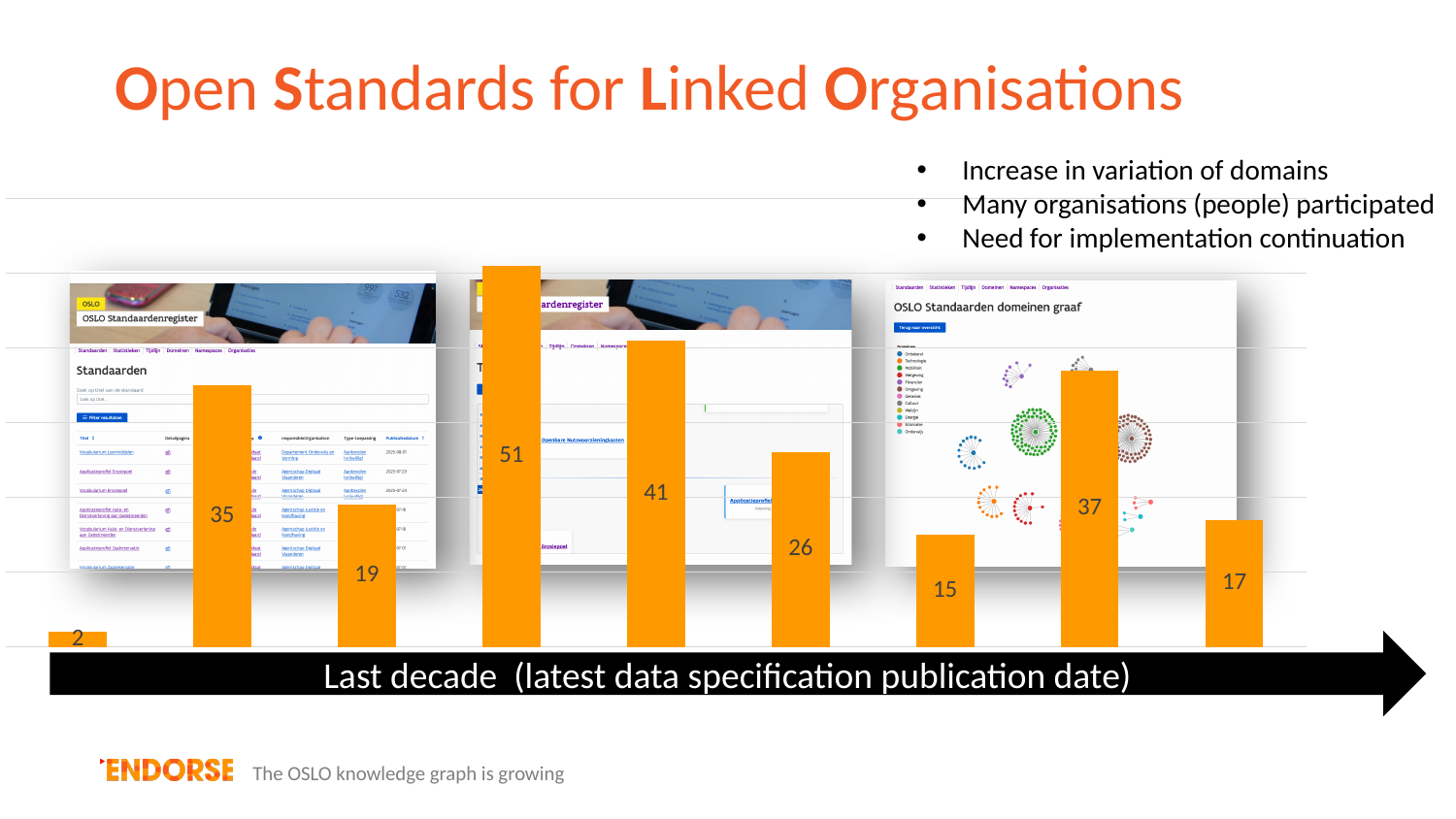
What is the difference between the bar labelled 35 and the bar labelled 19? 16 Which is larger: the bar labelled 41 or the bar labelled 37? 41 What is the value of the last (rightmost) bar in the chart? 17 What kind of chart is shown on the slide? bar chart What is the label written along the x axis of the chart? Last decade (latest data specification publication date) What is the value of the shortest bar in the chart? 2 What is the value of the tallest bar in the chart? 51 What is the value of the first (leftmost) bar in the chart? 2 What is the value of the second bar from the left in the chart? 35 How many bars does the chart contain? 9 What is the difference between the tallest bar (51) and the shortest bar (2)? 49 What is the value of the fourth bar from the left in the chart? 51